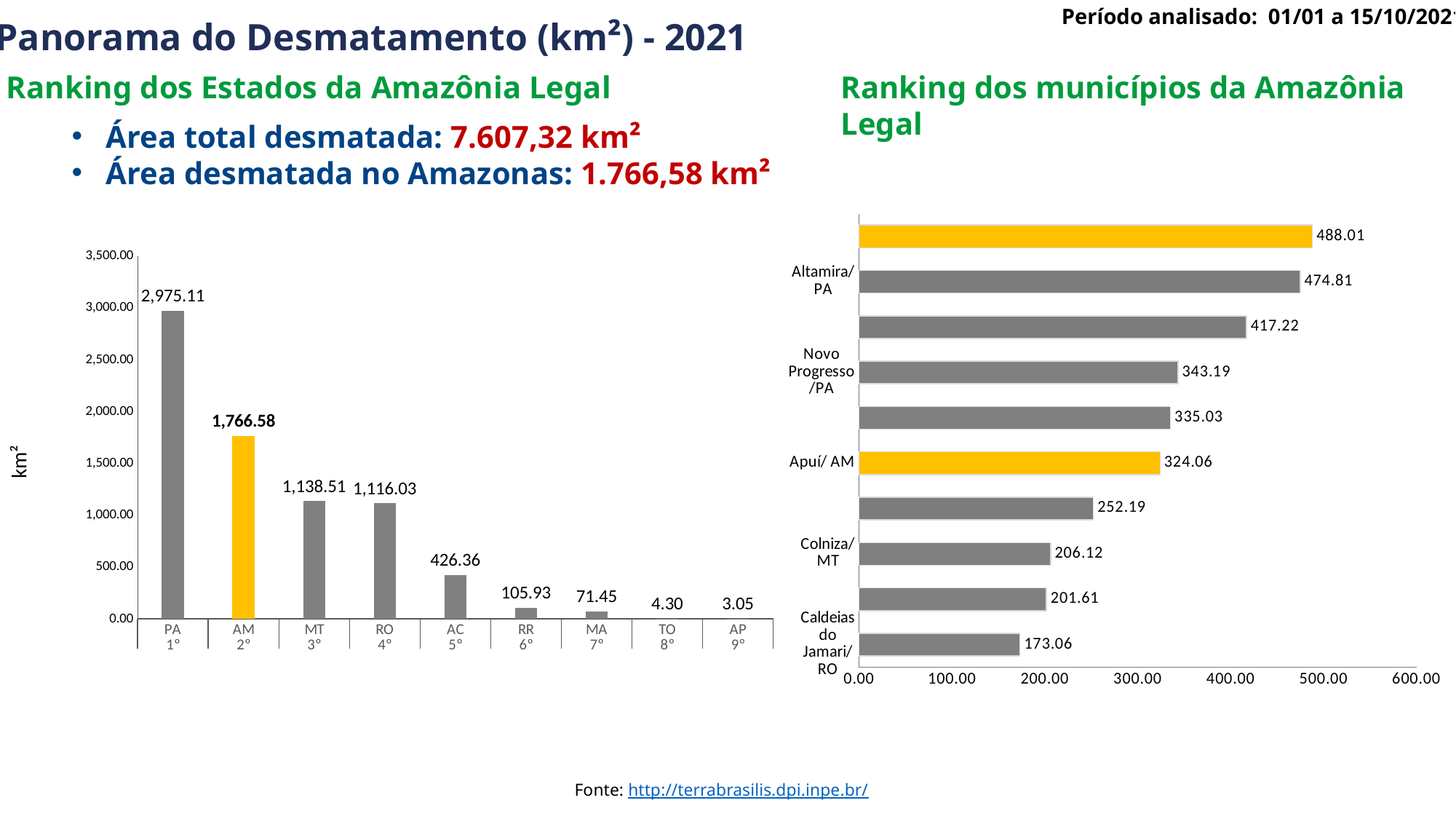
In the 'Ranking dos Estados da Amazônia Legal' chart, what is the difference between the values for MT and RO? 22.48 In the 'Ranking dos Estados da Amazônia Legal' chart, which state has the lowest value? AP In the 'Ranking dos Estados da Amazônia Legal' chart, what is the value for PA? 2,975.11 In the 'Ranking dos municípios da Amazônia Legal' chart, which is larger, the value for Novo Progresso/PA or the value for Colniza/MT? Novo Progresso/PA In the 'Ranking dos municípios da Amazônia Legal' chart, what is the value for Altamira/PA? 474.81 In the 'Ranking dos Estados da Amazônia Legal' chart, how many states are shown? 9 In the 'Ranking dos Estados da Amazônia Legal' chart, what is the value for AC? 426.36 What kind of chart is the 'Ranking dos municípios da Amazônia Legal' chart? bar chart In the 'Ranking dos municípios da Amazônia Legal' chart, how many bars are shown? 10 In the 'Ranking dos Estados da Amazônia Legal' chart, which state's bar is coloured yellow? AM In the 'Ranking dos Estados da Amazônia Legal' chart, do the values rise or fall from left to right along the x axis? fall In the 'Ranking dos municípios da Amazônia Legal' chart, what is the value for Apuí/AM? 324.06